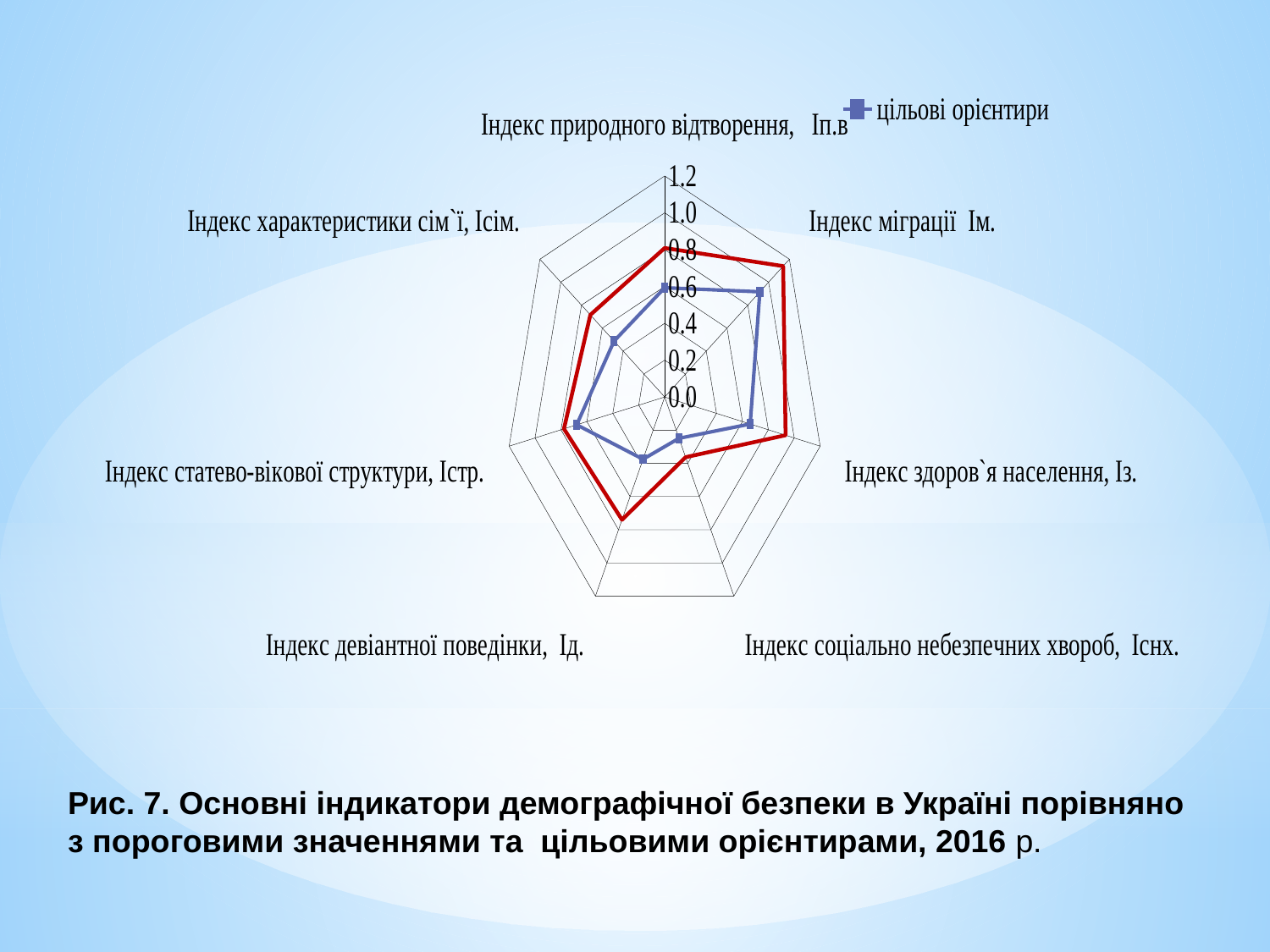
For Індекс здоров`я населення, Із., which series has the larger value: the red line or the blue 'цільові орієнтири' line? the red line What is the highest value marked on the radial axis of the chart? 1.2 Is the value of the blue 'цільові орієнтири' series for Індекс міграції, Ім. greater or less than 0.8? greater Is the value of the blue 'цільові орієнтири' series for Індекс соціально небезпечних хвороб, Існх. greater or less than 0.4? less For which index does the red series have its lowest value? Індекс соціально небезпечних хвороб, Існх. What kind of chart is shown on the slide? radar chart For which index does the blue 'цільові орієнтири' series have its lowest value? Індекс соціально небезпечних хвороб, Існх. How many indices (axes) does the radar chart have? 7 Is the value of the red series for Індекс природного відтворення, Іп.в greater or less than 0.6? greater What series name is shown in the chart legend? цільові орієнтири